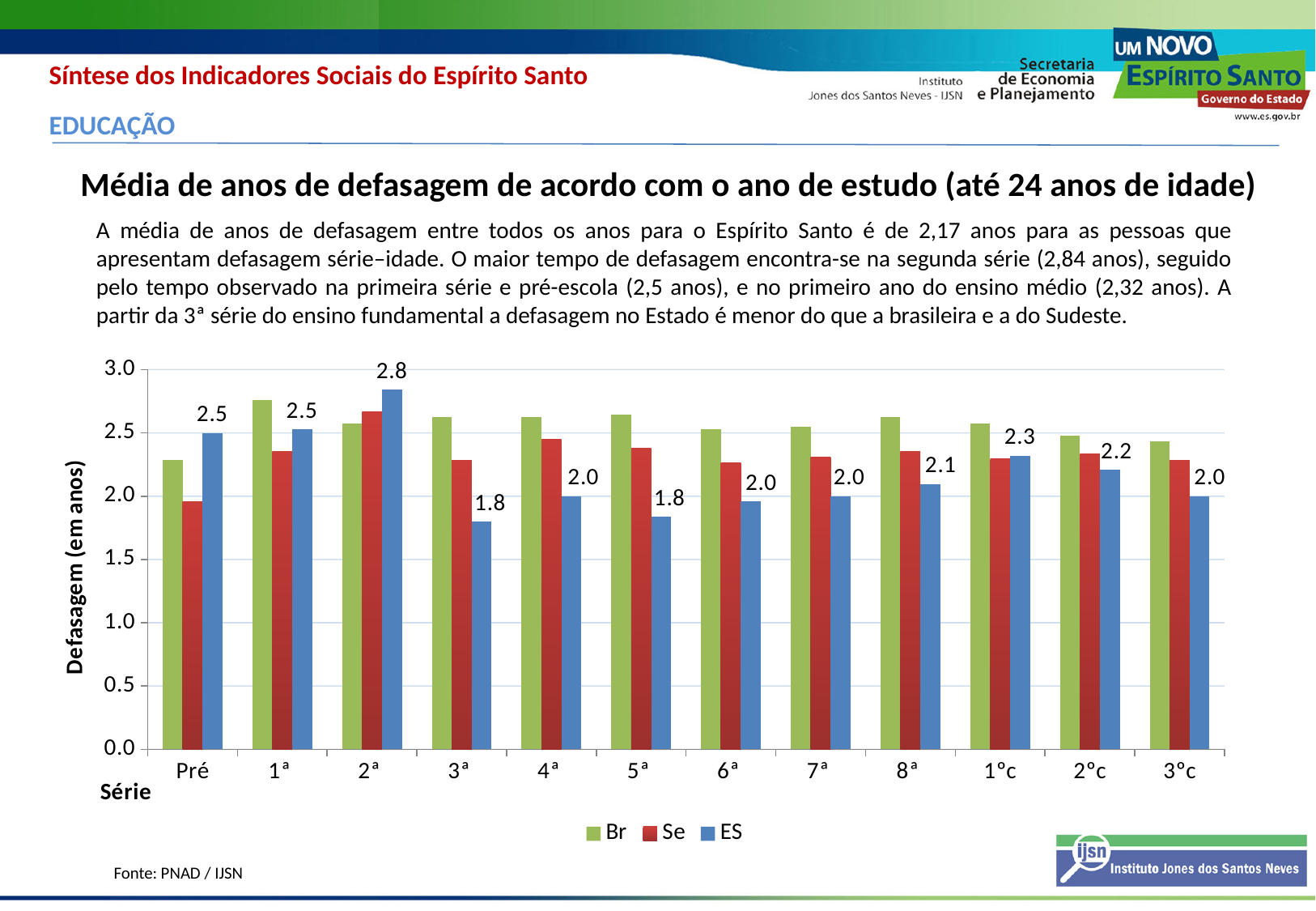
What is the difference between the ES value for 1°c and the ES value for 2°c? 0.1 What is the value for ES in the 1°c série? 2.3 How many series does the legend list? 3 Which is larger: the ES value for Pré or the ES value for 1°c? Pré What kind of chart is shown on the slide? Bar chart What is the value for ES in the 2ª série? 2.8 Which série has the highest value for ES? 2ª What is the difference between the ES value for 2ª and the ES value for 3ª? 1.0 How many séries are shown on the x axis? 12 Is the value for Se in the 3ª série greater or less than 2.5? less What is the value for ES in the 3ª série? 1.8 Is the value for Br in the 1ª série greater or less than 2.5? greater